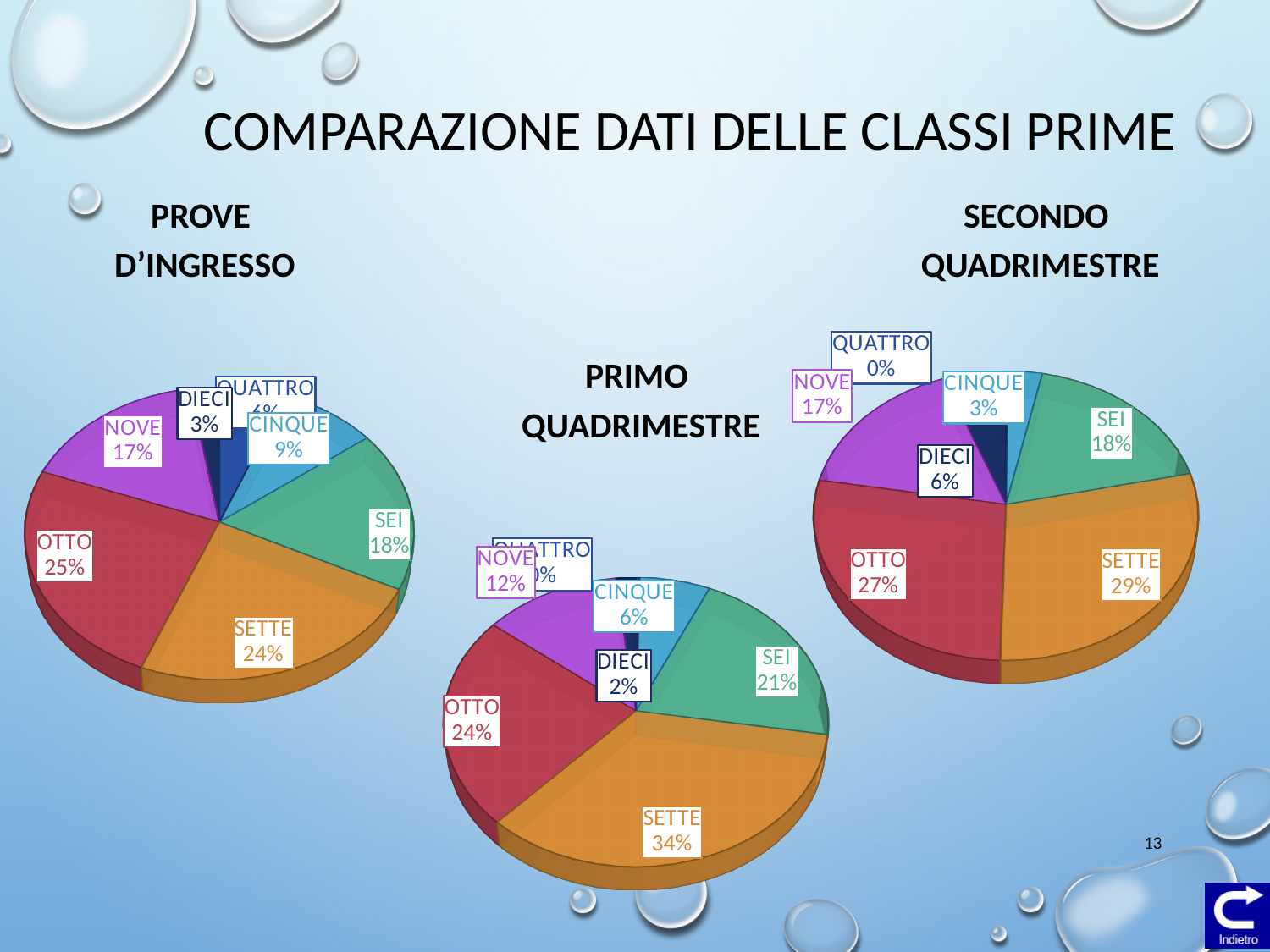
In the PROVE D'INGRESSO chart, what percentage is shown for OTTO? 25% In the SECONDO QUADRIMESTRE chart, which category has the largest share? SETTE In the SECONDO QUADRIMESTRE chart, what percentage is shown for NOVE? 17% How many pie charts are shown on the slide? 3 In the PRIMO QUADRIMESTRE chart, what percentage is shown for DIECI? 2% In the PRIMO QUADRIMESTRE chart, which category has the largest share? SETTE In the SECONDO QUADRIMESTRE chart, what is the difference between the shares for SETTE and OTTO? 2% In the SECONDO QUADRIMESTRE chart, which category has the smallest share? QUATTRO What kind of chart is the PRIMO QUADRIMESTRE chart? Pie chart In the PROVE D'INGRESSO chart, what percentage is shown for SEI? 18% In the PRIMO QUADRIMESTRE chart, what percentage is shown for SETTE? 34% In the PROVE D'INGRESSO chart, which is larger, the share for OTTO or the share for SETTE? OTTO